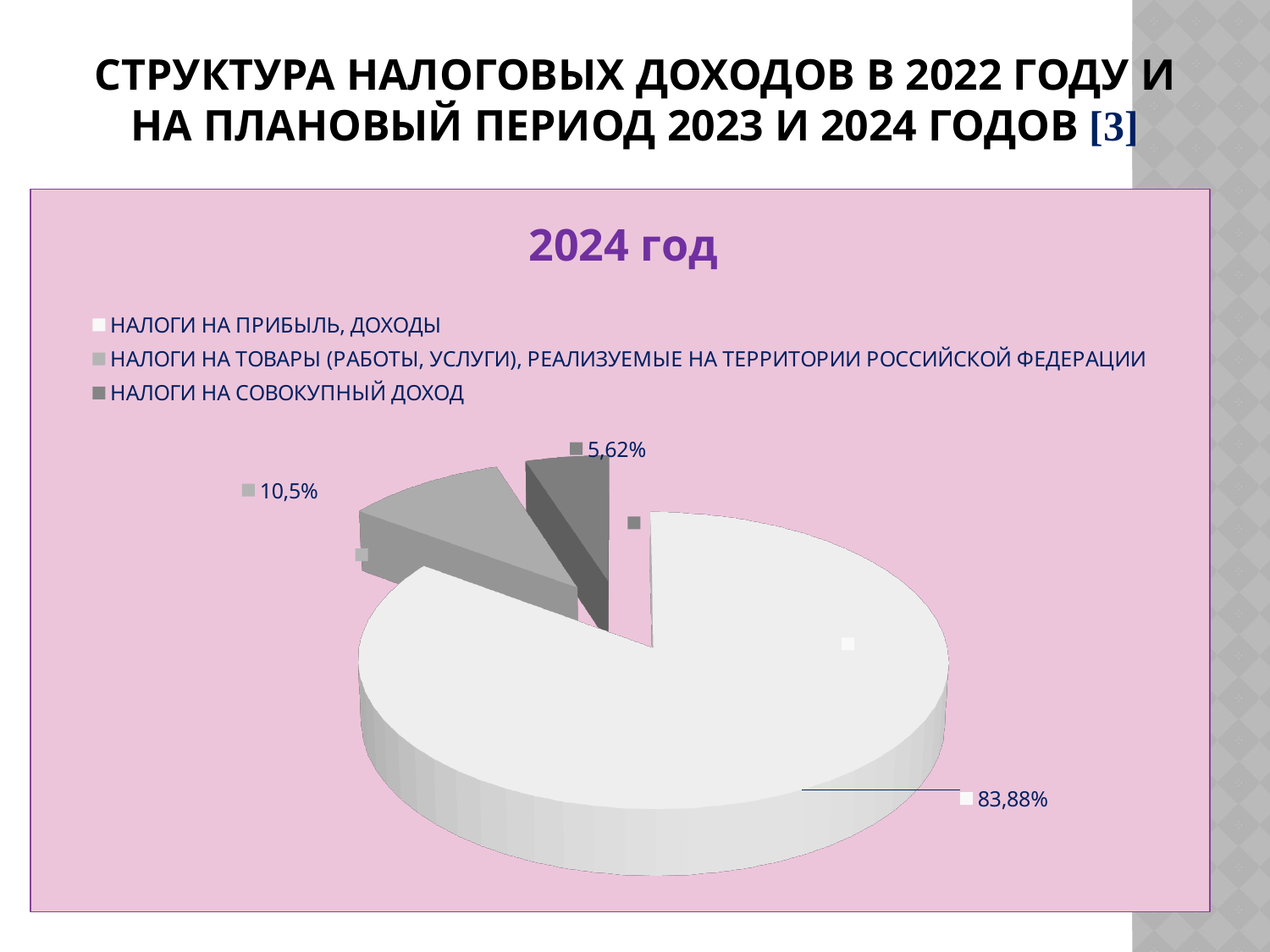
What is the chart's title? 2024 год Which legend entry is shown in the darkest grey colour? НАЛОГИ НА СОВОКУПНЫЙ ДОХОД What share of the pie is НАЛОГИ НА ПРИБЫЛЬ, ДОХОДЫ? 83,88% How many slices does the pie chart have? 3 Which category has the smallest slice of the pie? НАЛОГИ НА СОВОКУПНЫЙ ДОХОД What share of the pie is НАЛОГИ НА ТОВАРЫ (РАБОТЫ, УСЛУГИ), РЕАЛИЗУЕМЫЕ НА ТЕРРИТОРИИ РОССИЙСКОЙ ФЕДЕРАЦИИ? 10,5% What kind of chart is shown on the slide? Pie chart What is the difference in percentage points between the share for НАЛОГИ НА ТОВАРЫ (РАБОТЫ, УСЛУГИ) and the share for НАЛОГИ НА СОВОКУПНЫЙ ДОХОД? 4,88 What share of the pie is НАЛОГИ НА СОВОКУПНЫЙ ДОХОД? 5,62% How many entries does the legend list? 3 Which category has the largest slice of the pie? НАЛОГИ НА ПРИБЫЛЬ, ДОХОДЫ Which is larger: the share for НАЛОГИ НА ТОВАРЫ (РАБОТЫ, УСЛУГИ) or the share for НАЛОГИ НА СОВОКУПНЫЙ ДОХОД? НАЛОГИ НА ТОВАРЫ (РАБОТЫ, УСЛУГИ)